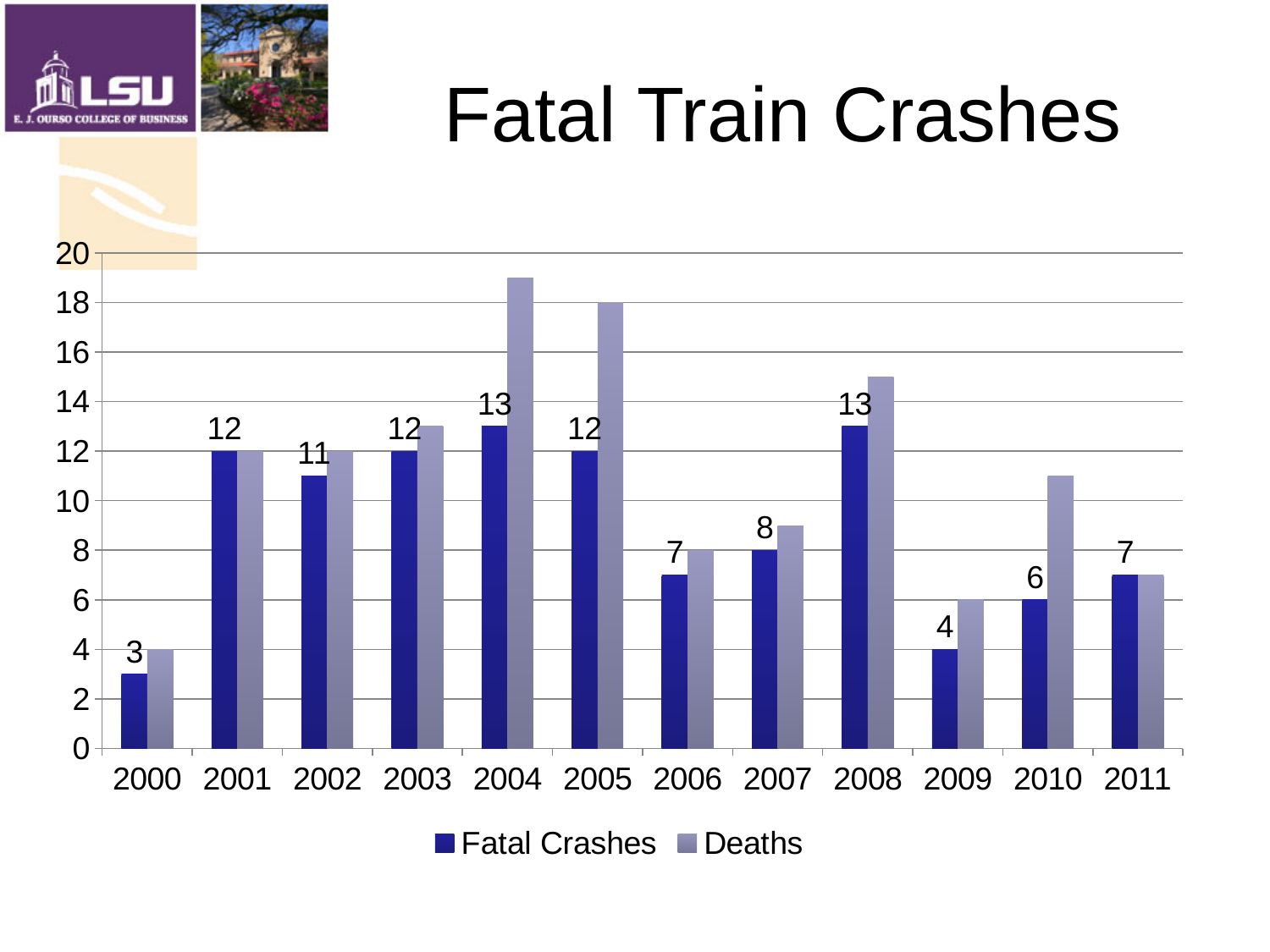
What is the difference between Fatal Crashes in 2004 and in 2000? 10 Is the value for Deaths in 2010 greater or less than 10? greater How many series does the legend list? 2 Is the value for Deaths in 2004 greater or less than 18? greater Which year has the lowest value for Deaths? 2000 What is the value for Deaths in 2000? 4 What is the value for Fatal Crashes in 2009? 4 Which is larger, Fatal Crashes in 2008 or Fatal Crashes in 2009? 2008 What is the value for Fatal Crashes in 2004? 13 Which year has the lowest value for Fatal Crashes? 2000 What is the value for Deaths in 2005? 18 How many years are shown on the x axis? 12